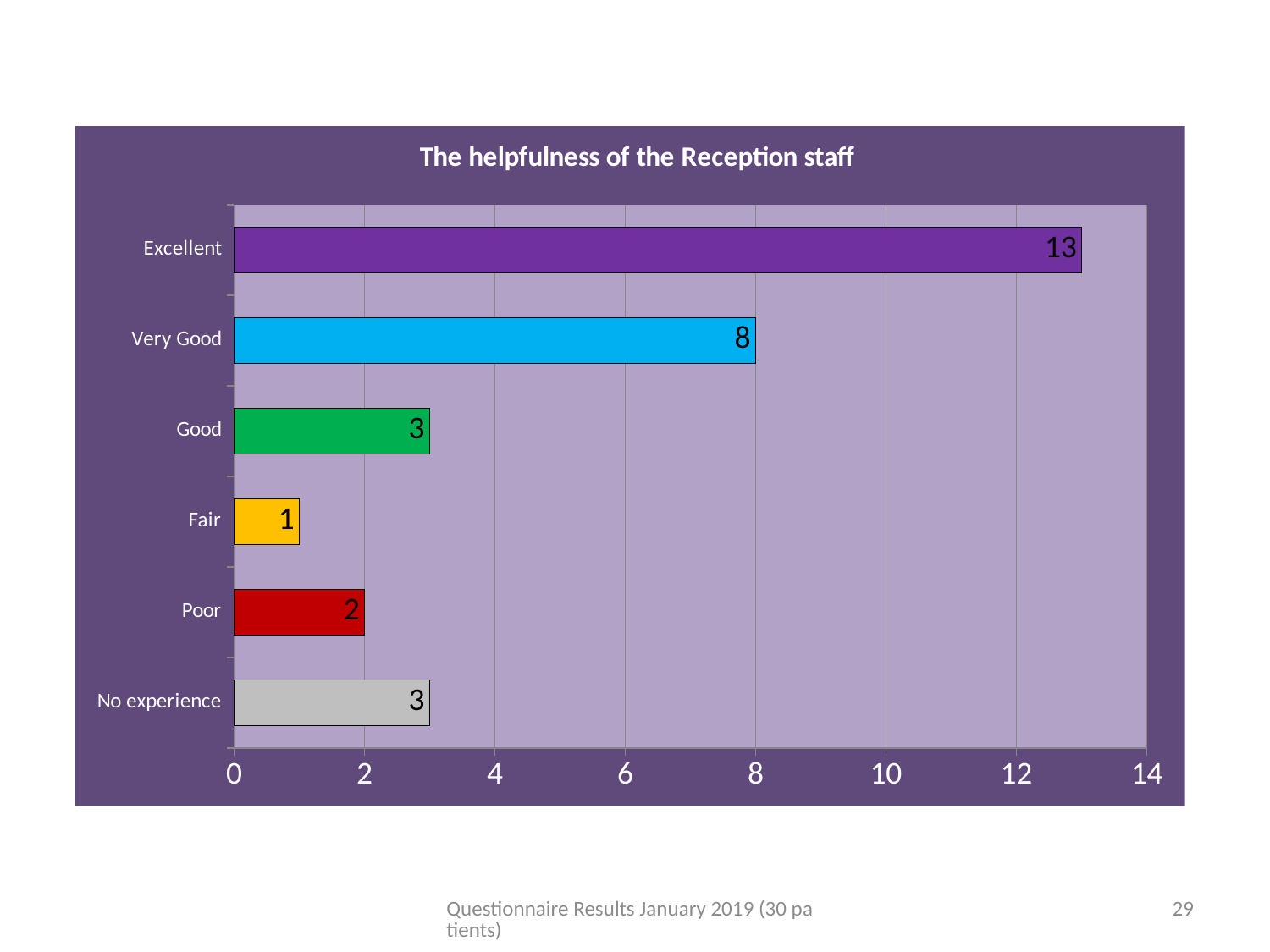
What is the value for Poor? 2 How many categories are shown in the chart? 6 Is the value for Very Good greater or less than 6? greater What kind of chart is shown on the slide? bar chart What is the value for Very Good? 8 Which is larger, the value for Good or the value for Poor? Good What is the title of the chart? The helpfulness of the Reception staff What is the value for No experience? 3 Which category has the highest value? Excellent Which category has the lowest value? Fair What is the difference between the values for Excellent and Very Good? 5 What is the value for Excellent? 13